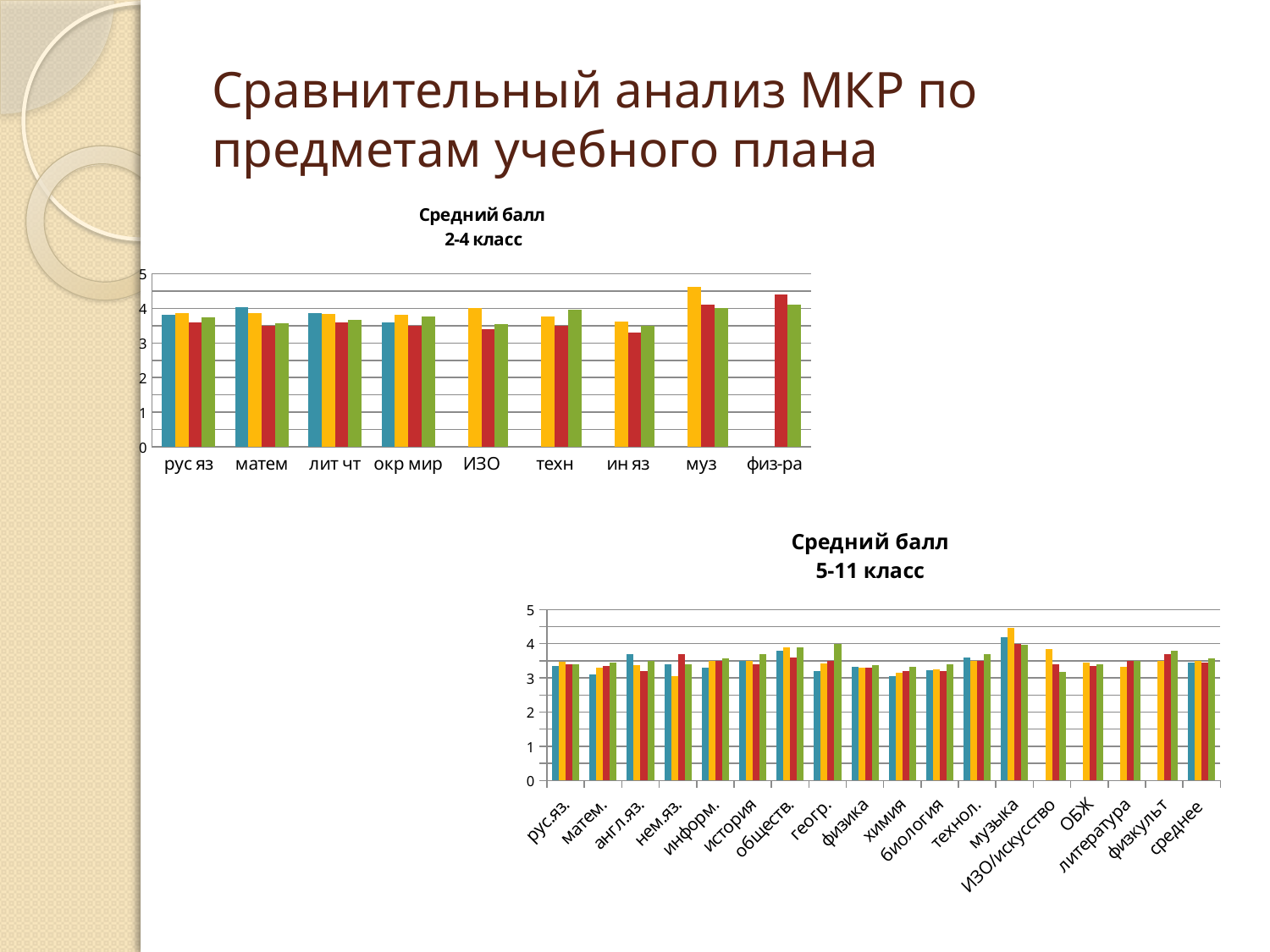
How many charts are on the slide? 2 In the 'Средний балл 2-4 класс' chart, are the bars for ин яз greater or less than 4? less In the 'Средний балл 2-4 класс' chart, is the tallest (yellow) bar for муз greater or less than 4? greater In the 'Средний балл 5-11 класс' chart, which subject has the tallest bar? музыка What kind of chart is the 'Средний балл 2-4 класс' chart? bar chart How many subject categories are shown on the x axis of the 'Средний балл 2-4 класс' chart? 9 How many categories are shown on the x axis of the 'Средний балл 5-11 класс' chart? 18 In the 'Средний балл 2-4 класс' chart, how many bars are shown for физ-ра? 2 In the 'Средний балл 2-4 класс' chart, which subject has the tallest bar? муз In the 'Средний балл 5-11 класс' chart, are the bars for химия greater or less than 4? less What kind of chart is the 'Средний балл 5-11 класс' chart? bar chart In the 'Средний балл 5-11 класс' chart, which has the taller bars, музыка or физика? музыка